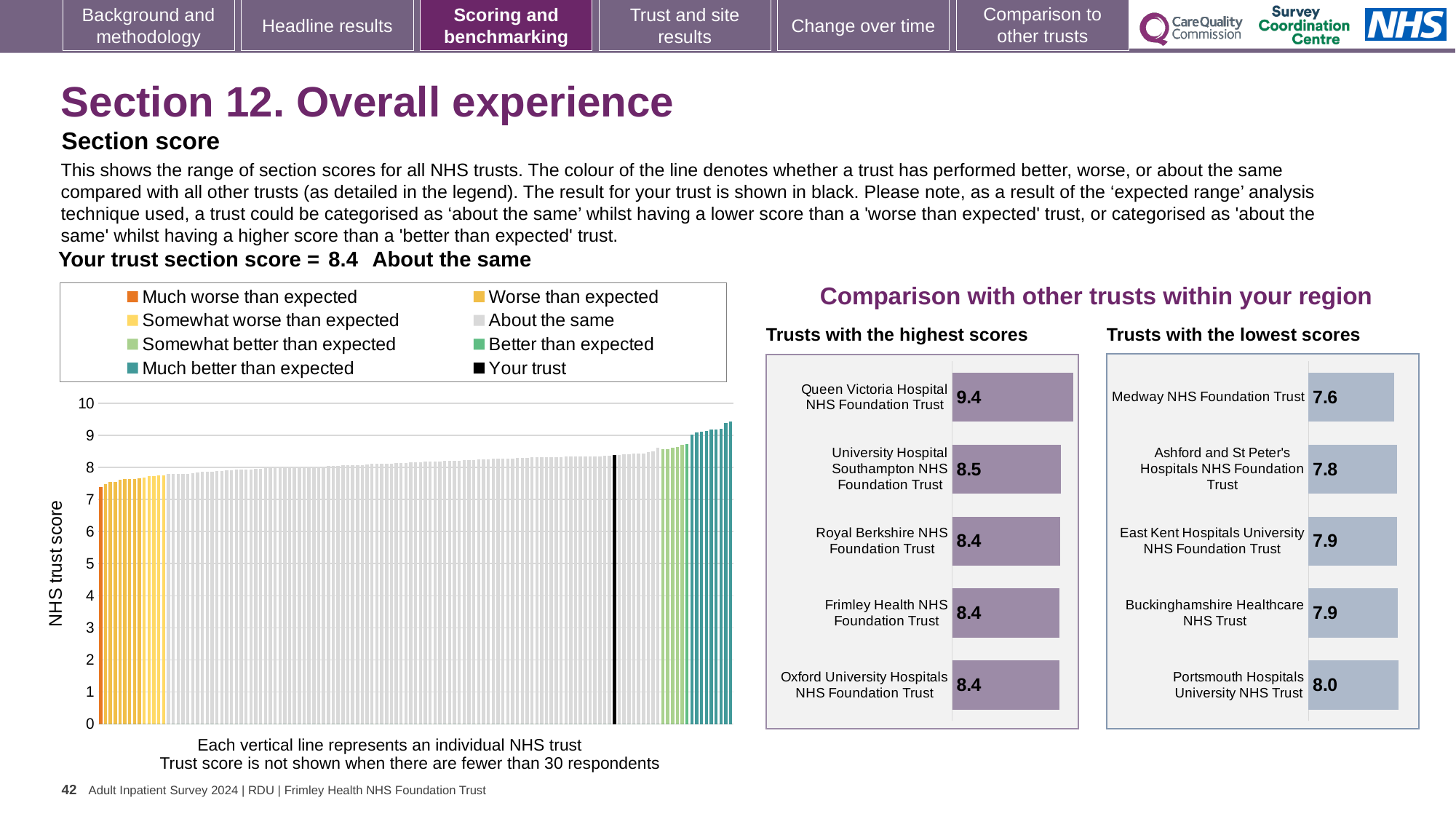
How many trusts are shown in the 'Trusts with the highest scores' chart? 5 In the 'Trusts with the lowest scores' chart, which has the higher score: Ashford and St Peter's Hospitals NHS Foundation Trust or East Kent Hospitals University NHS Foundation Trust? East Kent Hospitals University NHS Foundation Trust In the 'Trusts with the lowest scores' chart, what is the difference between the scores of Portsmouth Hospitals University NHS Trust and Medway NHS Foundation Trust? 0.4 In the 'Trusts with the lowest scores' chart, what is the score for Medway NHS Foundation Trust? 7.6 In the 'Trusts with the highest scores' chart, which trust has the highest score? Queen Victoria Hospital NHS Foundation Trust In the 'Trusts with the lowest scores' chart, which trust has the lowest score? Medway NHS Foundation Trust What kind of chart is the 'Trusts with the lowest scores' chart? Bar chart In the main 'NHS trust score' chart, is the value for your trust (the black bar) greater or less than 8? greater How many entries does the legend of the main 'NHS trust score' chart list? 8 What is the title of the section containing the two small bar charts on the right of the slide? Comparison with other trusts within your region In the 'Trusts with the highest scores' chart, what is the score for Queen Victoria Hospital NHS Foundation Trust? 9.4 In the 'Trusts with the highest scores' chart, what is the difference between the scores of Queen Victoria Hospital NHS Foundation Trust and University Hospital Southampton NHS Foundation Trust? 0.9